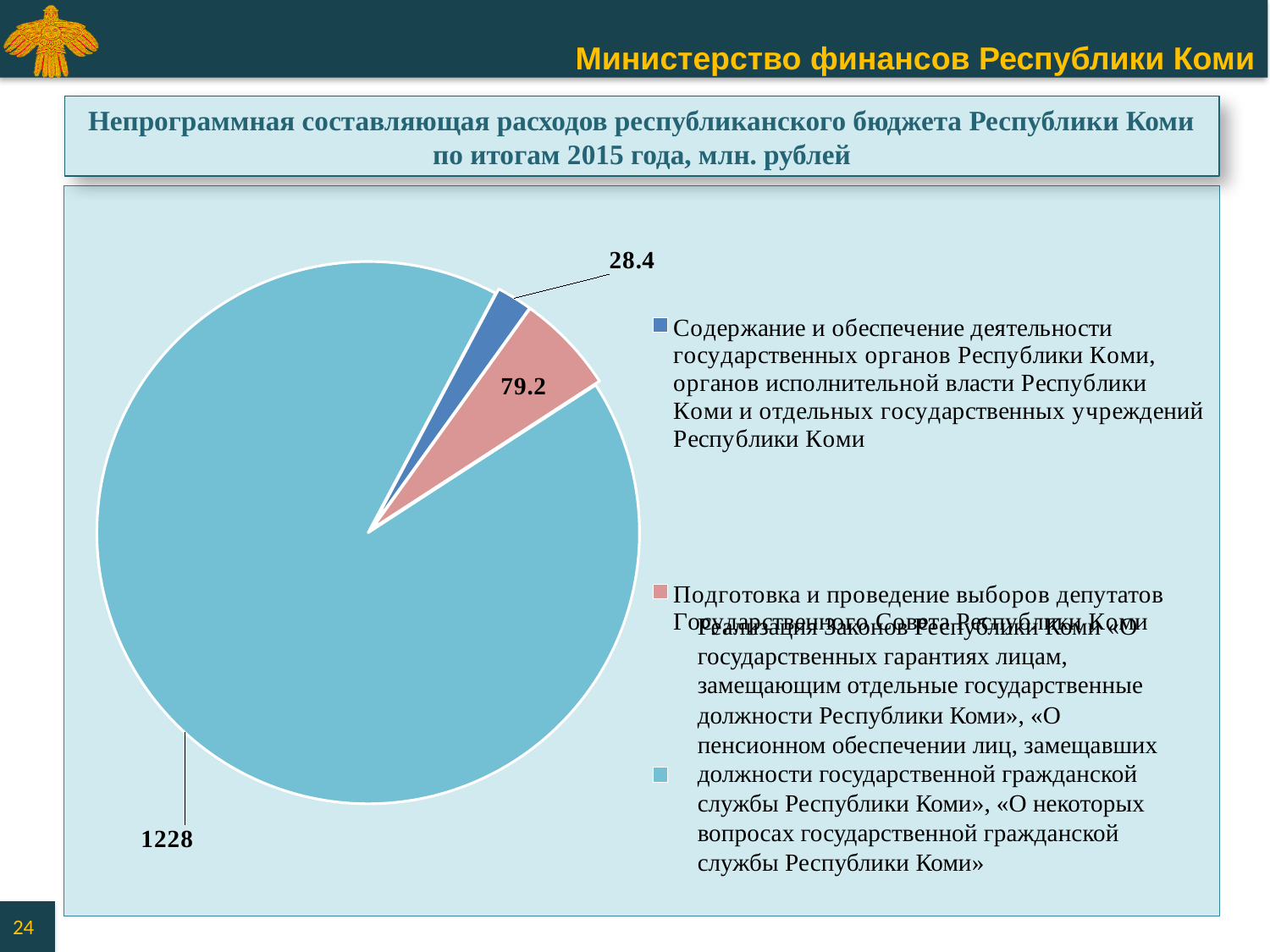
What is the total of all three slices in the pie chart? 1335.6 What is the value of the slice for «Содержание и обеспечение деятельности государственных органов Республики Коми...»? 28.4 What kind of chart is shown on the slide? Pie chart What is the difference between the largest slice (1228) and the slice for elections (79.2)? 1148.8 How many slices does the pie chart have? 3 What is the difference between the slice labelled 79.2 and the slice labelled 28.4? 50.8 What is the value of the slice for «Подготовка и проведение выборов депутатов Государственного Совета Республики Коми»? 79.2 In what units are the values in the chart expressed, according to the title? млн. рублей Which category has the smallest slice in the pie chart? Содержание и обеспечение деятельности государственных органов Республики Коми, органов исполнительной власти Республики Коми и отдельных государственных учреждений Республики Коми What is the value of the largest slice of the pie chart? 1228 Which category has the largest slice in the pie chart? Реализация законов Республики Коми «О государственных гарантиях лицам, замещающим отдельные государственные должности Республики Коми»... Which is larger: the slice for elections of deputies or the slice for maintenance of state bodies? Elections of deputies (79.2)